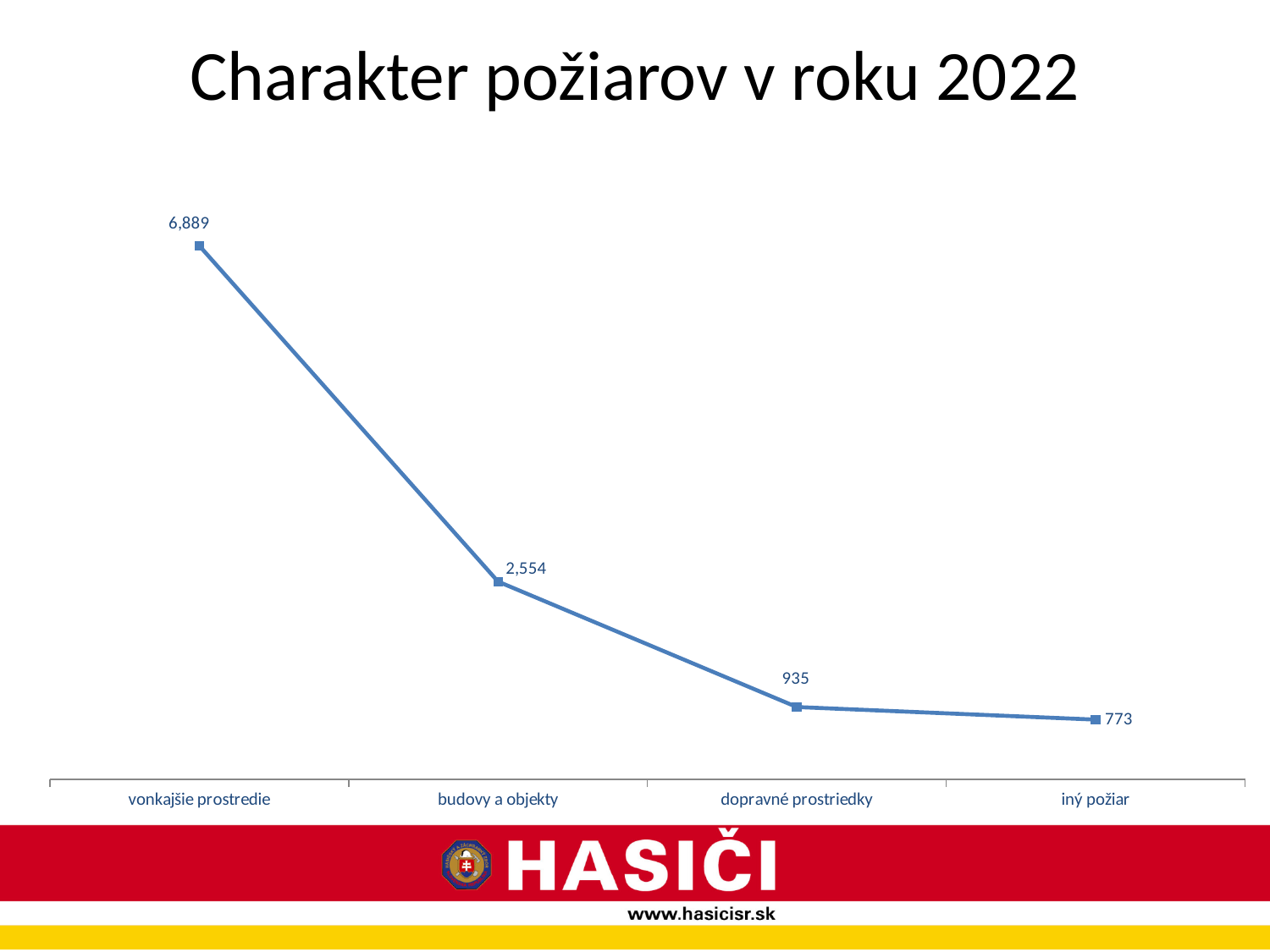
What is the value for vonkajšie prostredie? 6,889 Which category has the lowest value? iný požiar What is the value for dopravné prostriedky? 935 What is the difference between the values for dopravné prostriedky and iný požiar? 162 Which is larger, the value for budovy a objekty or the value for dopravné prostriedky? budovy a objekty What is the difference between the values for vonkajšie prostredie and budovy a objekty? 4,335 What kind of chart is shown on the slide? line chart Which category has the highest value? vonkajšie prostredie What is the value for budovy a objekty? 2,554 How many categories are plotted on the chart? 4 What is the value for iný požiar? 773 Do the values rise or fall from left to right along the x axis? fall